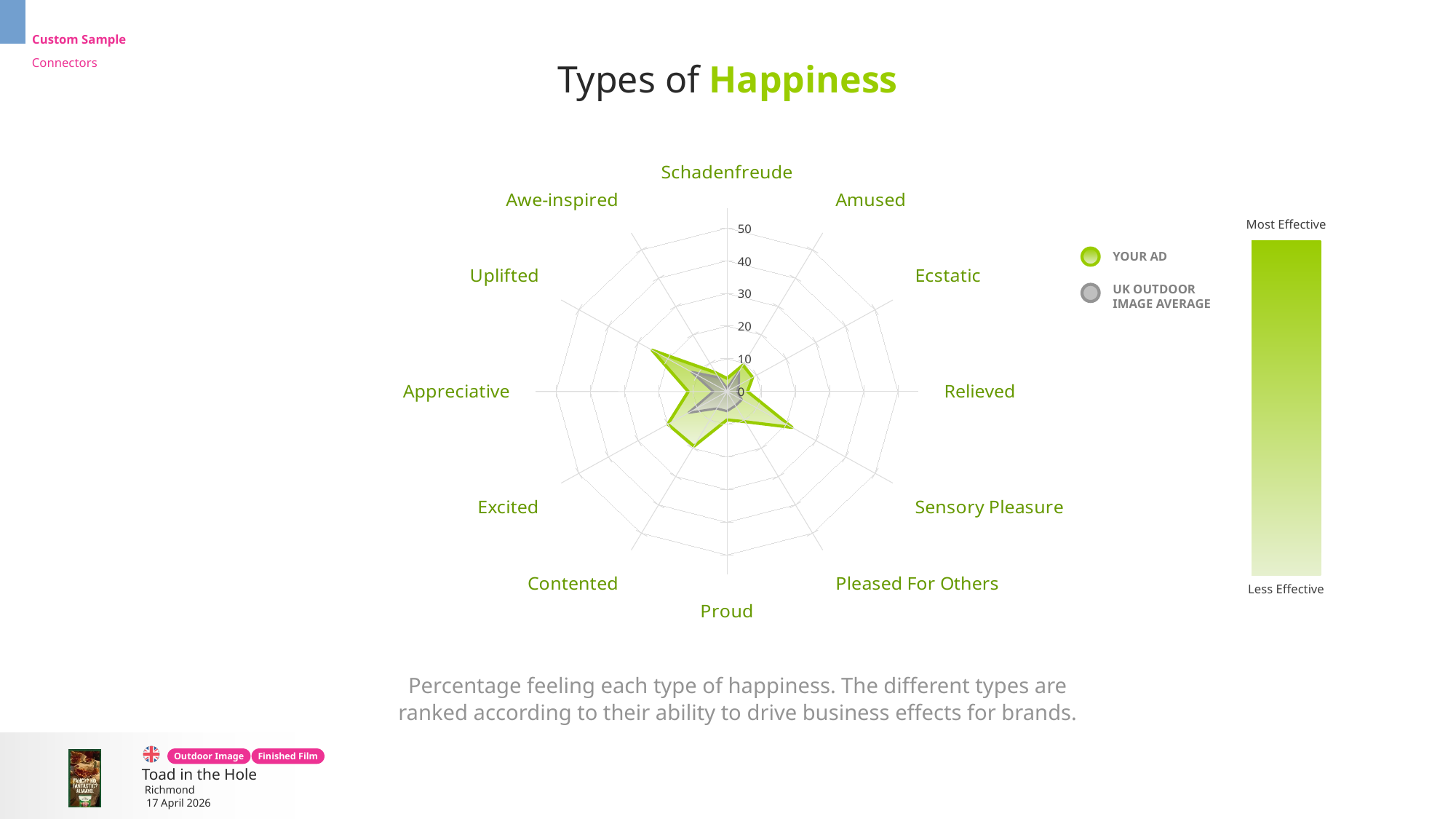
Is the YOUR AD value for Sensory Pleasure greater or less than 10? greater How many types of happiness are plotted around the radar chart? 12 Is the YOUR AD value for Relieved greater or less than 20? less What is the title of the chart? Types of Happiness Is the YOUR AD value for Awe-inspired greater or less than 10? less What are the two series named in the legend? YOUR AD and UK OUTDOOR IMAGE AVERAGE How many series does the legend list? 2 What kind of chart is shown on the slide? radar chart